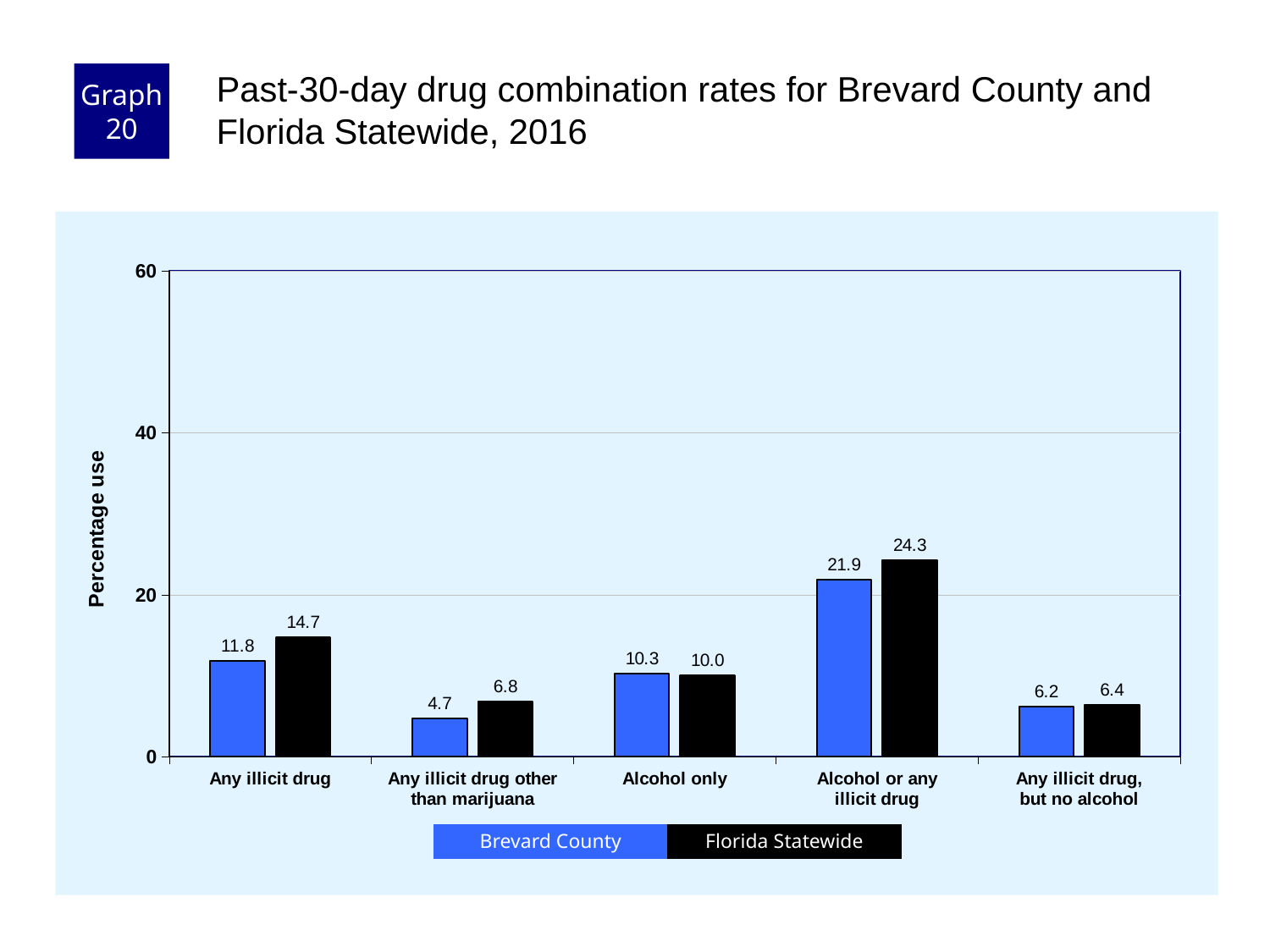
Which category has the highest Brevard County value? Alcohol or any illicit drug What is the Florida Statewide value for Alcohol or any illicit drug? 24.3 What kind of chart is shown on the slide? bar chart What is the difference between the Florida Statewide and Brevard County values for Any illicit drug? 2.9 What is the label of the y axis? Percentage use Which category has the lowest Florida Statewide value? Any illicit drug, but no alcohol Which is larger for Alcohol only: Brevard County or Florida Statewide? Brevard County How many series does the legend list? 2 What is the Brevard County value for Any illicit drug? 11.8 Is the Florida Statewide value for Alcohol or any illicit drug greater or less than 20? greater How many categories are shown on the x axis? 5 What is the Florida Statewide value for Any illicit drug other than marijuana? 6.8